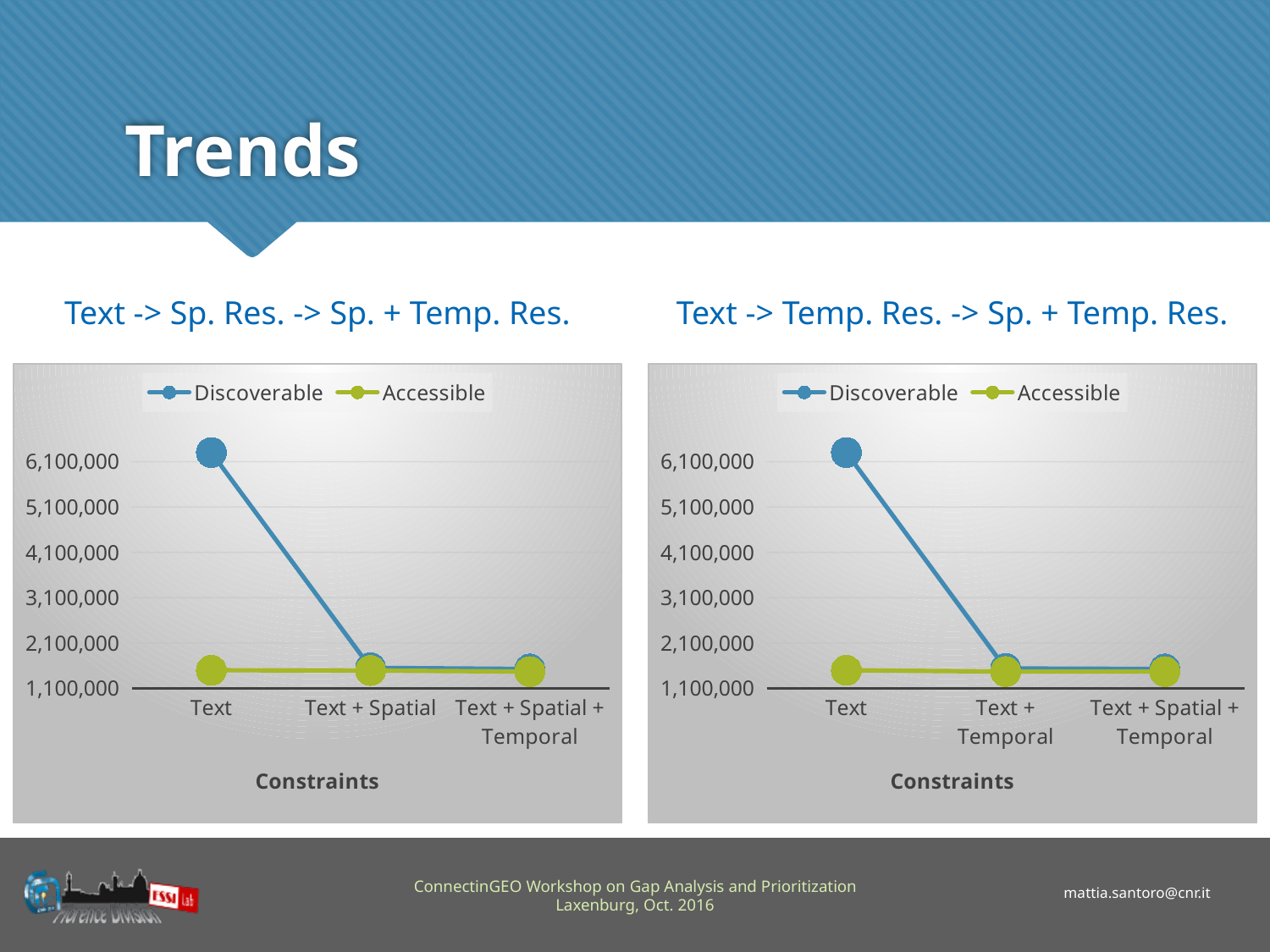
In the left chart (Text -> Sp. Res. -> Sp. + Temp. Res.), which series has the larger value for Text, Discoverable or Accessible? Discoverable In the right chart (Text -> Temp. Res. -> Sp. + Temp. Res.), what is the label of the middle category on the x axis? Text + Temporal In the left chart (Text -> Sp. Res. -> Sp. + Temp. Res.), is the Discoverable value for Text + Spatial greater or less than 2,100,000? less In the left chart (Text -> Sp. Res. -> Sp. + Temp. Res.), what kind of chart is shown? line chart In the right chart (Text -> Temp. Res. -> Sp. + Temp. Res.), what is the x-axis title? Constraints In the left chart (Text -> Sp. Res. -> Sp. + Temp. Res.), does the Discoverable series rise or fall from Text to Text + Spatial + Temporal? fall In the left chart (Text -> Sp. Res. -> Sp. + Temp. Res.), is the Discoverable value for Text greater or less than 5,100,000? greater In the right chart (Text -> Temp. Res. -> Sp. + Temp. Res.), is the Accessible value for Text greater or less than 2,100,000? less In the left chart (Text -> Sp. Res. -> Sp. + Temp. Res.), how many categories are on the x axis? 3 In the left chart (Text -> Sp. Res. -> Sp. + Temp. Res.), for which constraint is the Discoverable value highest? Text In the left chart (Text -> Sp. Res. -> Sp. + Temp. Res.), how many series does the legend list? 2 In the right chart (Text -> Temp. Res. -> Sp. + Temp. Res.), for which constraint is the Discoverable value highest? Text